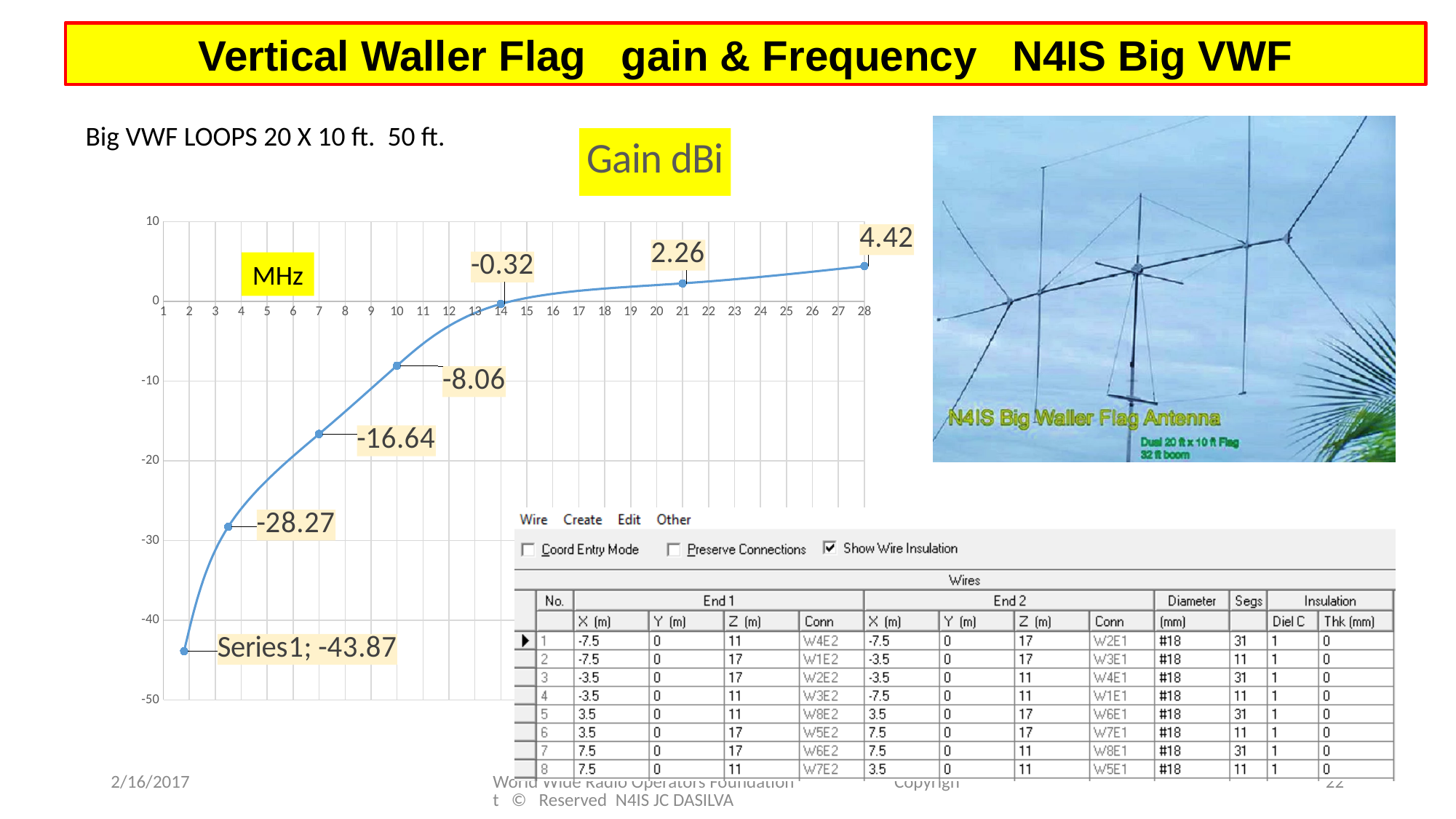
What type of chart is shown on the slide? line chart What is the gain value of the lowest-frequency point on the chart? -43.87 What is the gain value at 7 MHz? -16.64 What is the gain value at 10 MHz? -8.06 How many data points are plotted on the chart? 7 Which is larger, the gain at 10 MHz or the gain at 7 MHz? 10 MHz What is the gain value at 14 MHz? -0.32 Does the gain rise or fall as frequency increases along the x axis? rise What is the gain value at 21 MHz? 2.26 At which frequency is the gain highest? 28 MHz What is the gain value at 28 MHz? 4.42 What is the difference between the gain at 28 MHz and the gain at 21 MHz? 2.16